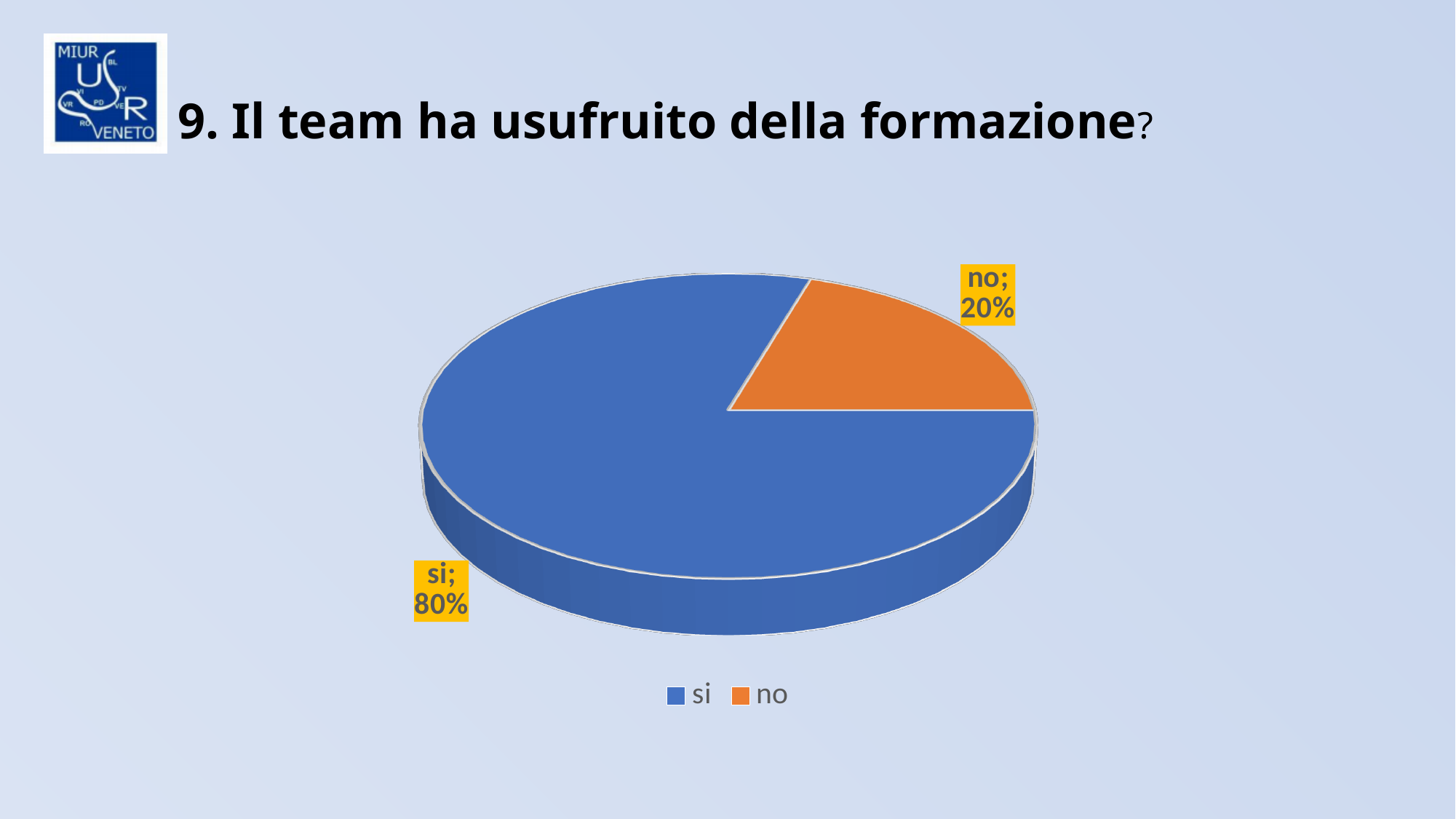
What share of the pie does the "si" slice represent? 80% What is the difference in percentage points between the "si" and "no" slices? 60% What kind of chart is shown on the slide? pie chart Which category has the largest slice of the pie? si What is the title of the slide containing the chart? 9. Il team ha usufruito della formazione? How many categories are shown in the pie chart? 2 Which is larger, the "si" slice or the "no" slice? si What share of the pie does the "no" slice represent? 20% Which category has the smallest slice of the pie? no What colour is the "no" slice in the pie chart? orange